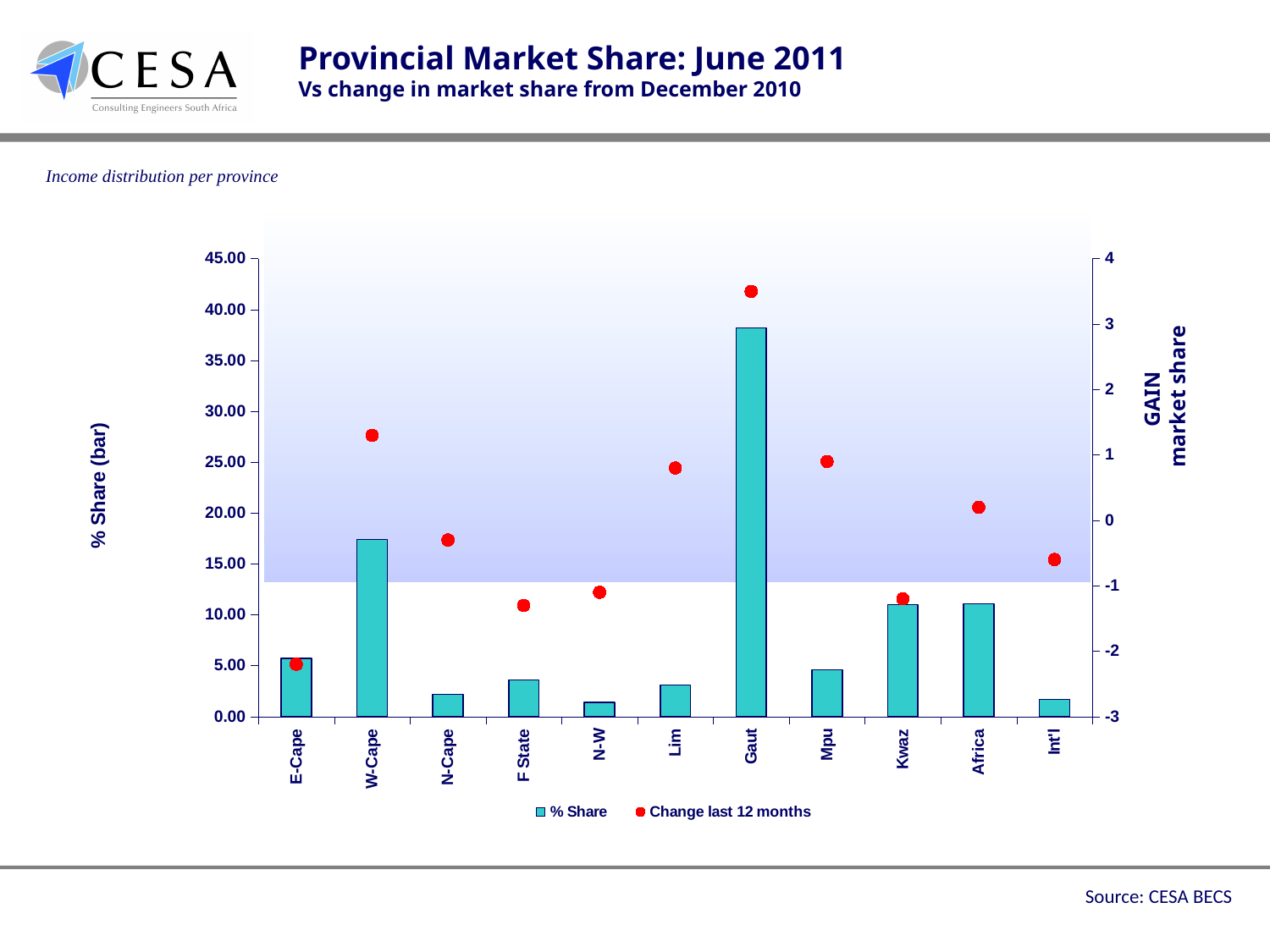
Is the % Share value for E-Cape greater or less than 10.00? less Which has the larger % Share bar, W-Cape or Kwaz? W-Cape Is the 'Change last 12 months' value for E-Cape greater or less than -1? less Which category has the highest 'Change last 12 months' value? Gaut Which category has the lowest 'Change last 12 months' value? E-Cape How many series does the legend list? 2 Is the % Share value for W-Cape greater or less than 15.00? greater How many categories are shown on the x axis? 11 Which province has the highest % Share bar? Gaut What kind of chart is shown on the slide? bar chart with dot markers on a secondary axis